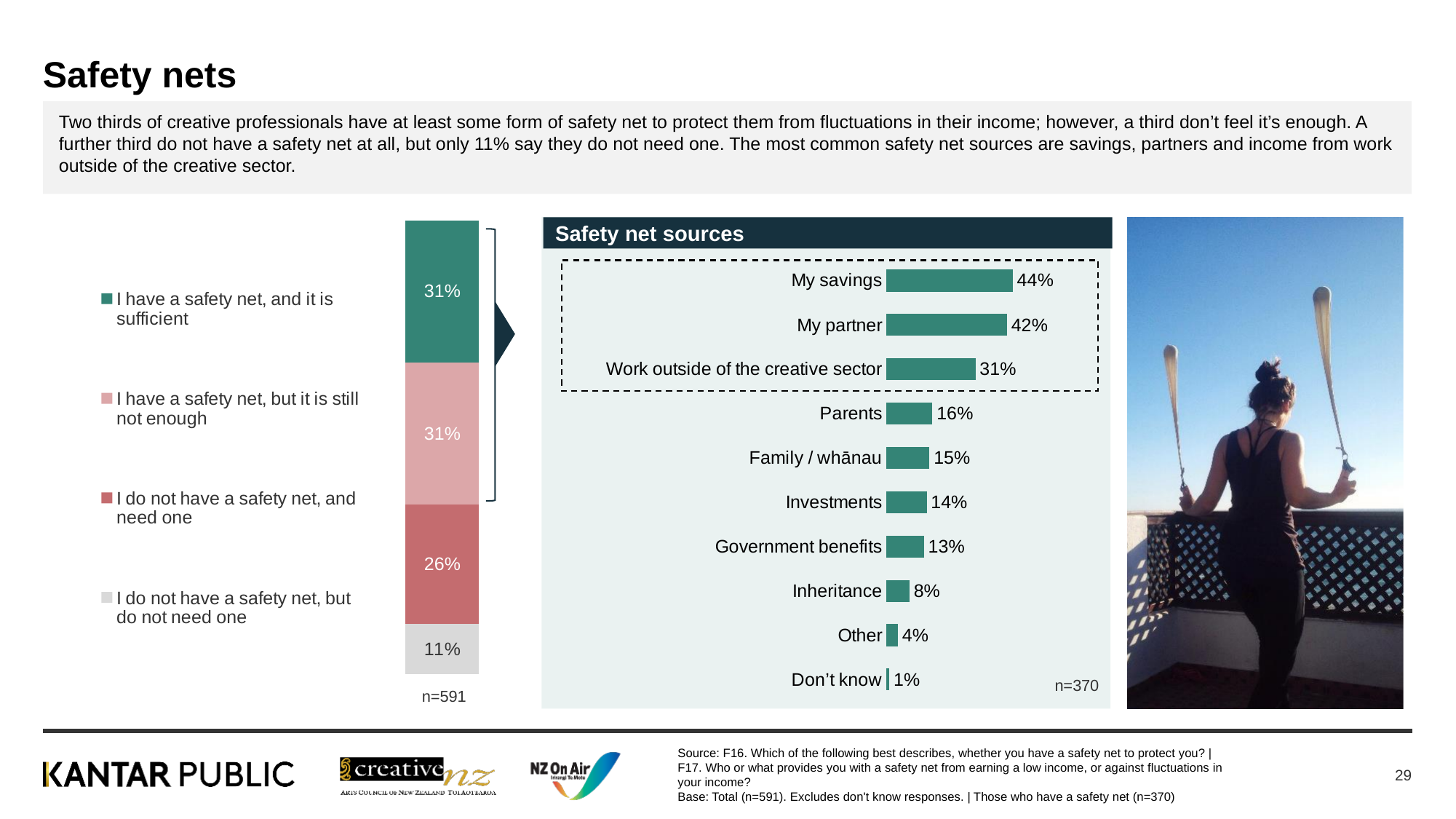
What is the sample size (n) shown for the 'Safety net sources' chart? n=370 In the 'Safety net sources' chart, what is the difference between My partner and Work outside of the creative sector? 11% How many series does the legend of the stacked bar chart on the left list? 4 In the 'Safety net sources' chart, what is the value for My savings? 44% How many categories are shown in the 'Safety net sources' chart? 10 In the stacked bar chart on the left, what is the value for 'I do not have a safety net, and need one'? 26% In the 'Safety net sources' chart, which category has the highest value? My savings In the 'Safety net sources' chart, which is larger: Parents or Investments? Parents In the stacked bar chart on the left, what is the value for 'I do not have a safety net, but do not need one'? 11% In the 'Safety net sources' chart, what is the value for Government benefits? 13% In the 'Safety net sources' chart, which category has the lowest value? Don't know What kind of chart is the 'Safety net sources' chart? Bar chart